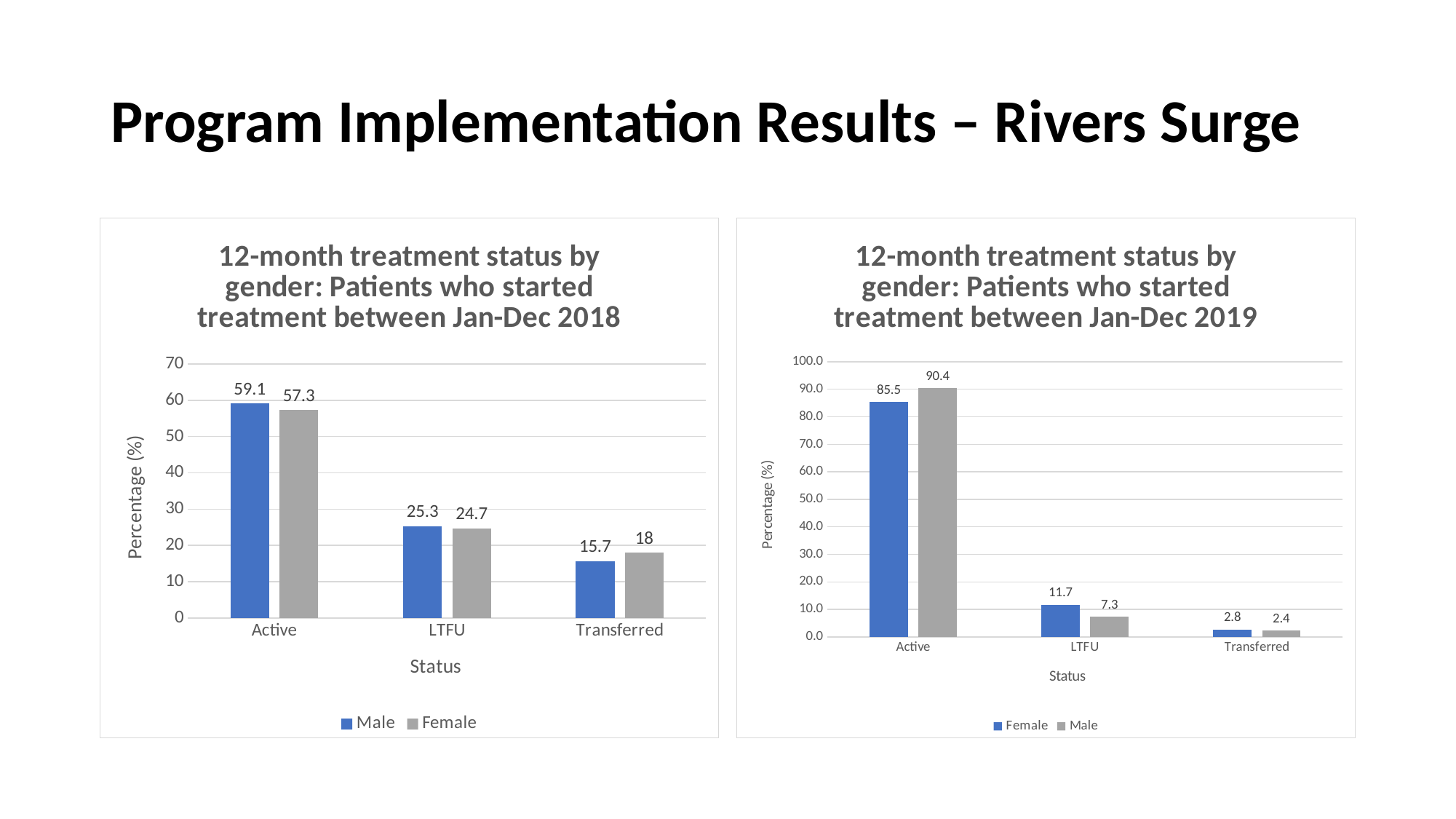
What type of chart is the 2018 chart (left)? Bar chart In the 2019 chart (right), what is the value for Male patients with Active status? 90.4 In the 2019 chart (right), which is larger for LTFU: the Female value or the Male value? Female In the 2019 chart (right), what is the value for Female patients with LTFU status? 11.7 In the 2018 chart (left), what is the value for Female patients with Transferred status? 18 How many series does the legend of the 2019 chart (right) list? 2 In the 2018 chart (left), what is the value for Male patients with Active status? 59.1 In the 2019 chart (right), what is the difference between the Male and Female values for Active? 4.9 In the 2018 chart (left), what is the difference between the Male and Female values for LTFU? 0.6 In the 2018 chart (left), which status has the lowest value for Male patients? Transferred How many status categories are shown on the x axis of the 2018 chart (left)? 3 In the 2019 chart (right), which status has the highest value for Female patients? Active